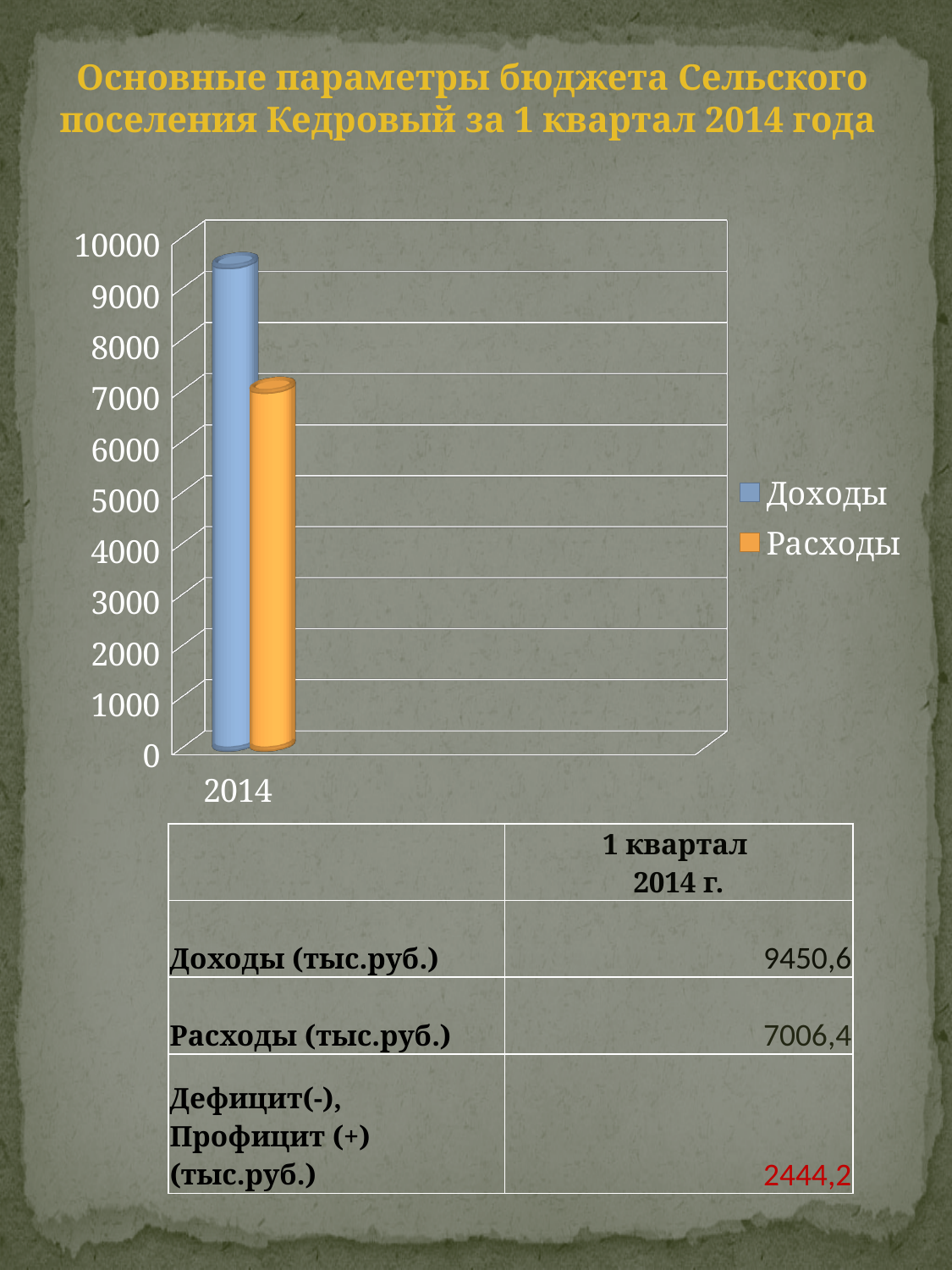
How many series does the chart legend list? 2 What kind of chart is shown on the slide? bar chart According to the table on the slide, what is the value of Доходы (тыс.руб.) for 1 квартал 2014 г.? 9450,6 Is the value for Доходы greater or less than 9000? greater What is the difference between Доходы and Расходы as shown on the slide? 2444,2 How many categories are shown on the x axis of the chart? 1 Which series has the lowest bar in the chart? Расходы What category label appears on the x axis of the chart? 2014 According to the table on the slide, what is the value of Расходы (тыс.руб.) for 1 квартал 2014 г.? 7006,4 Which series is higher in the chart, Доходы or Расходы? Доходы Is the value for Расходы greater or less than 6000? greater Is the value for Расходы greater or less than 8000? less